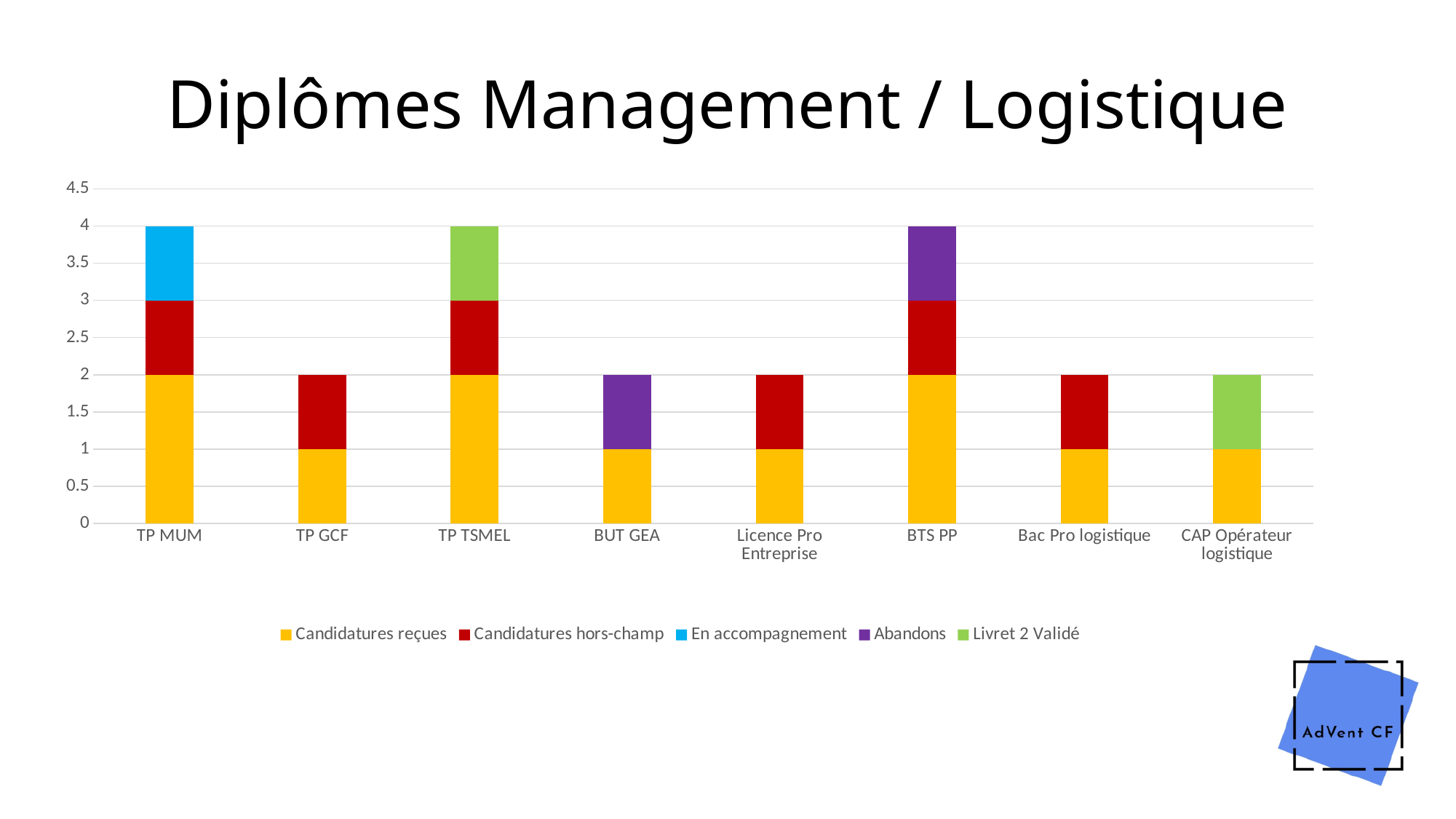
Is the total bar for Licence Pro Entreprise greater or less than 3? less What is the difference between the total bar for TP TSMEL and the total bar for CAP Opérateur logistique? 2 What is the value of Candidatures reçues for Bac Pro logistique? 1 What kind of chart is shown on the slide? Stacked bar chart How many diploma categories are shown on the x axis? 8 What is the total height of the stacked bar for TP MUM? 4 What is the value of Candidatures reçues for TP TSMEL? 2 What is the total height of the stacked bar for TP GCF? 2 Which is larger, the total bar for BTS PP or the total bar for BUT GEA? BTS PP What is the title of the chart? Diplômes Management / Logistique Which series appears only in the TP MUM bar? En accompagnement How many series does the legend list? 5